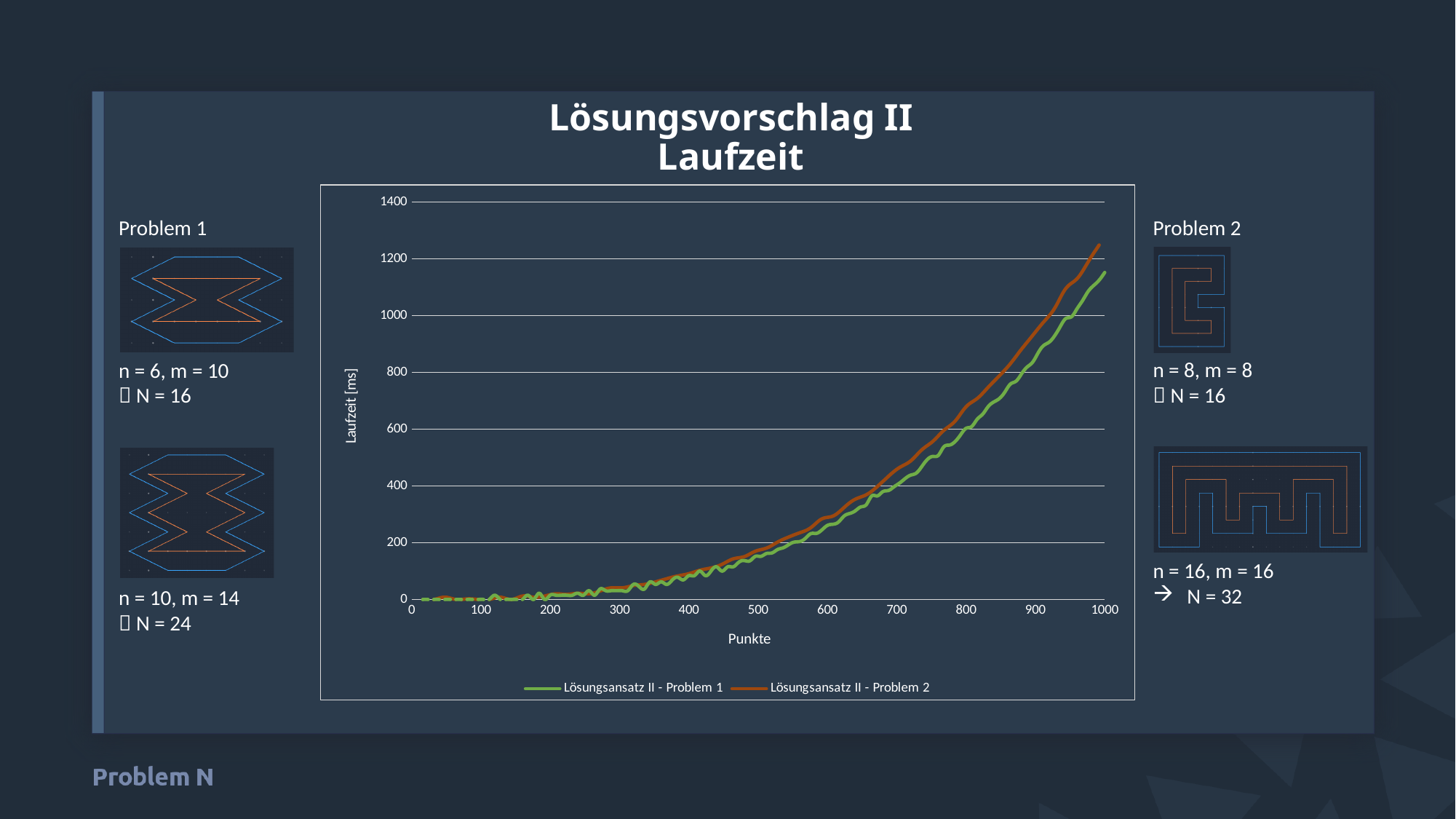
What is the label of the y axis of the chart? Laufzeit [ms] Do the values of the series 'Lösungsansatz II - Problem 2' rise or fall as Punkte increases? rise At 500 Punkte, is the value for 'Lösungsansatz II - Problem 1' greater or less than 200? less At 1000 Punkte, is the value for 'Lösungsansatz II - Problem 1' greater or less than 1000? greater Do the values of the series 'Lösungsansatz II - Problem 1' rise or fall as Punkte increases? rise At 1000 Punkte, is the value for 'Lösungsansatz II - Problem 2' greater or less than 1200? greater What kind of chart is shown on the slide? line chart At 1000 Punkte, which series has the higher value, 'Lösungsansatz II - Problem 1' or 'Lösungsansatz II - Problem 2'? Lösungsansatz II - Problem 2 How many series does the chart legend list? 2 At 800 Punkte, which series has the lower value, 'Lösungsansatz II - Problem 1' or 'Lösungsansatz II - Problem 2'? Lösungsansatz II - Problem 1 What is the label of the x axis of the chart? Punkte